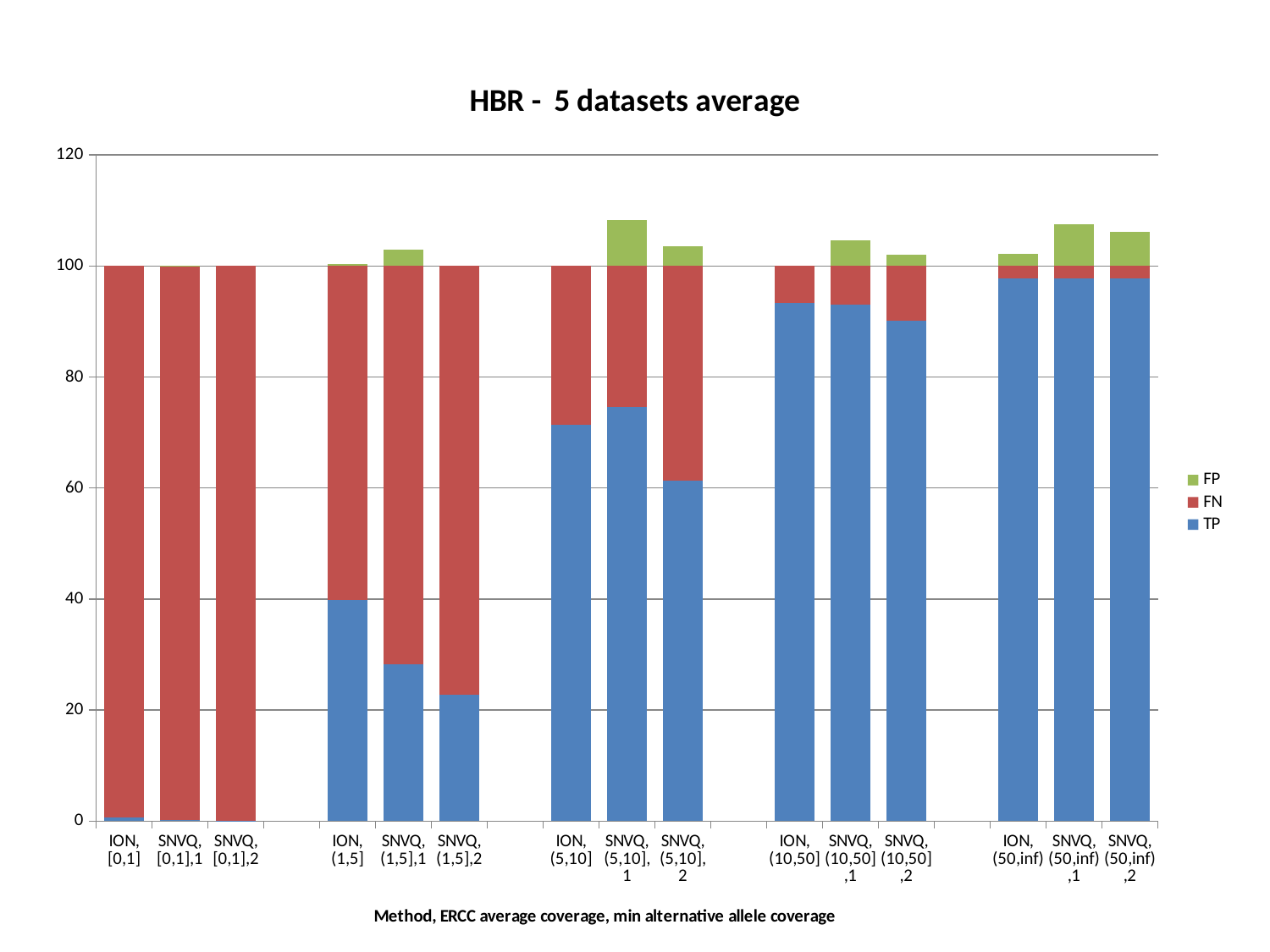
What is the title of the chart? HBR - 5 datasets average Does the TP value generally rise or fall as the ERCC average coverage group increases from [0,1] to (50,inf)? rise Which has the larger TP value: SNVQ, (1,5],1 or SNVQ, (1,5],2? SNVQ, (1,5],1 Is the TP value for ION, (50,inf) greater or less than 80? greater Is the TP value for ION, (10,50] greater or less than 80? greater How many bars (categories) are plotted along the x axis? 15 Is the TP value for SNVQ, (1,5],1 greater or less than 40? less How many series does the legend list? 3 Which has the larger TP value: ION, (5,10] or SNVQ, (5,10],2? ION, (5,10] What kind of chart is shown on the slide? Stacked bar chart Which series is shown in blue in the legend? TP